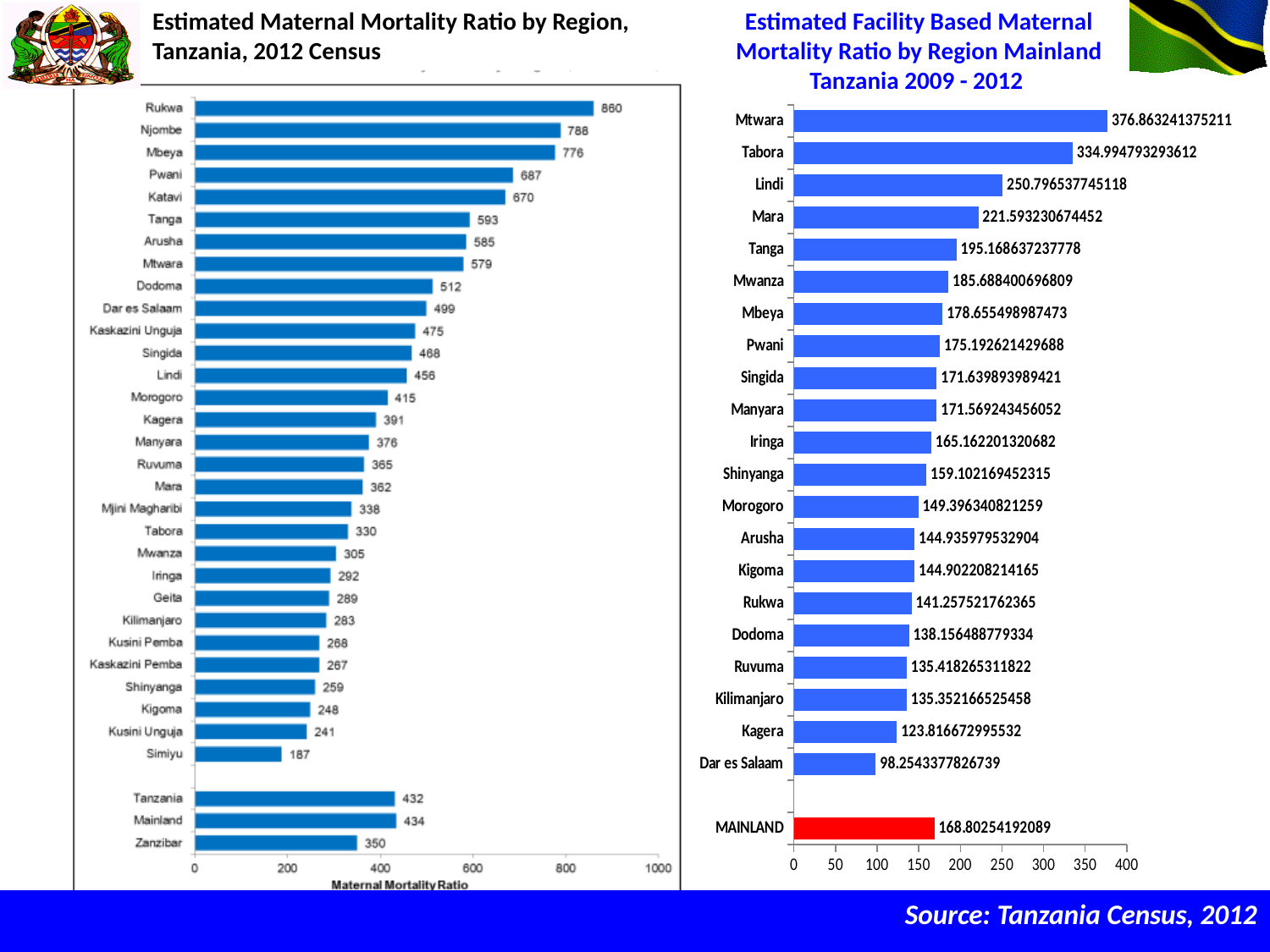
In the left chart (2012 Census), which is larger, the value for Njombe or the value for Mbeya? Njombe In the left chart (2012 Census), what is the difference between the Mainland value and the Zanzibar value? 84 In the right chart (Facility Based, 2009 - 2012), which is larger, the value for Lindi or the value for Mara? Lindi In the left chart (Estimated Maternal Mortality Ratio by Region, Tanzania, 2012 Census), what is the maternal mortality ratio for Rukwa? 860 In the right chart (Facility Based, 2009 - 2012), what colour is the MAINLAND bar? Red In the right chart (Facility Based, 2009 - 2012), what is the value shown for Dar es Salaam? 98.2543377826739 In the left chart (2012 Census), what is the difference between the values for Rukwa and Simiyu? 673 In the left chart (2012 Census), what is the value shown for Zanzibar? 350 How many bars are plotted in the right chart (Facility Based, 2009 - 2012), including MAINLAND? 22 In the left chart (2012 Census), which region has the lowest maternal mortality ratio? Simiyu In the right chart (Estimated Facility Based Maternal Mortality Ratio, 2009 - 2012), which region has the highest value? Mtwara In the right chart (Facility Based, 2009 - 2012), what is the value shown for MAINLAND? 168.80254192089